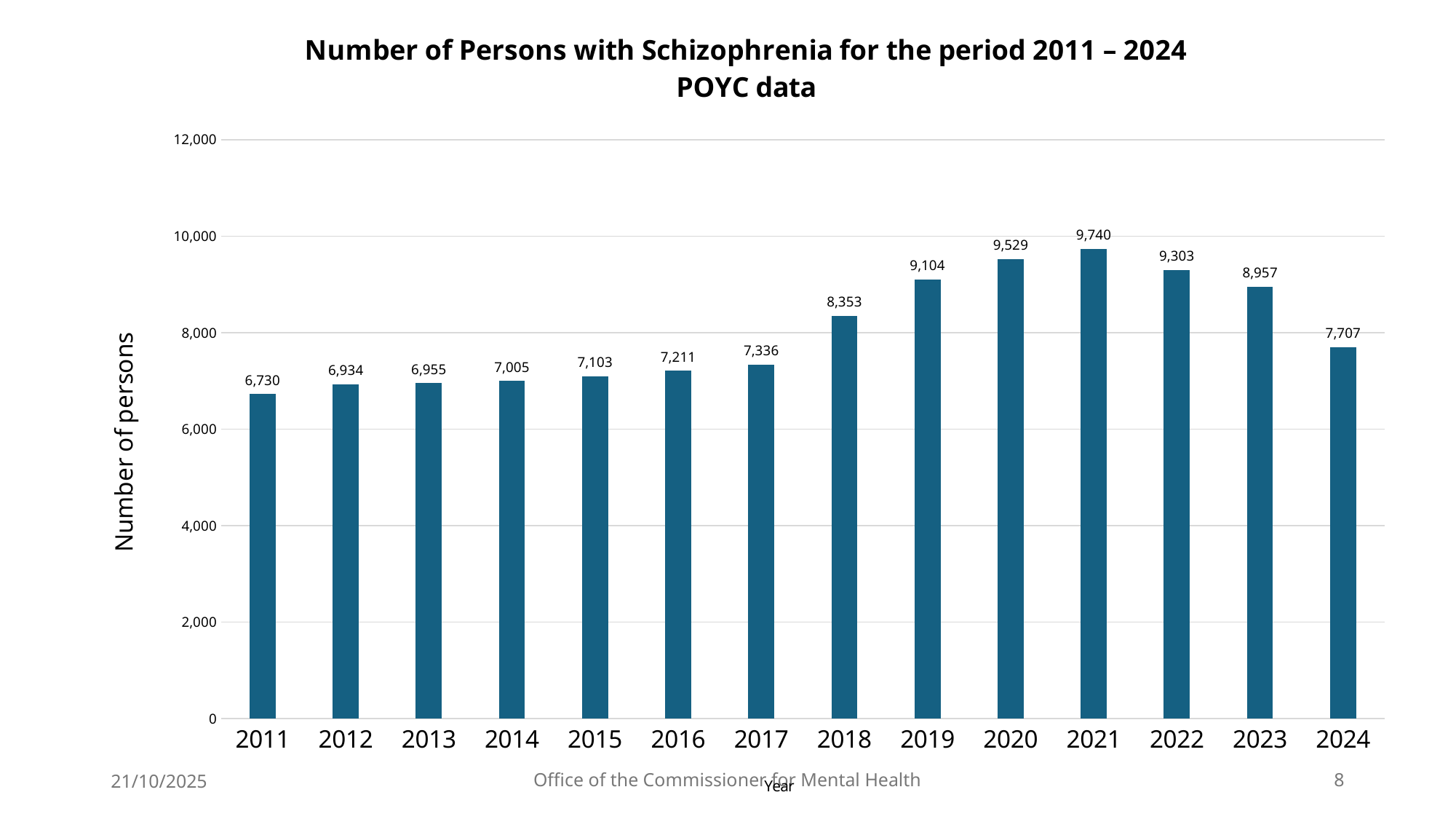
Which year has a larger number of persons, 2019 or 2022? 2022 How many years are shown on the x axis? 14 Which year has the highest number of persons with schizophrenia? 2021 Which year has the lowest number of persons with schizophrenia? 2011 What is the number of persons with schizophrenia in 2011? 6,730 Do the values rise or fall from 2011 to 2021? Rise What is the difference between the number of persons in 2021 and in 2024? 2,033 What kind of chart is shown on the slide? Bar chart What is the number of persons with schizophrenia in 2021? 9,740 Is the value for 2020 greater or less than 8,000? greater What is the number of persons with schizophrenia in 2024? 7,707 What is the difference between the number of persons in 2018 and in 2017? 1,017